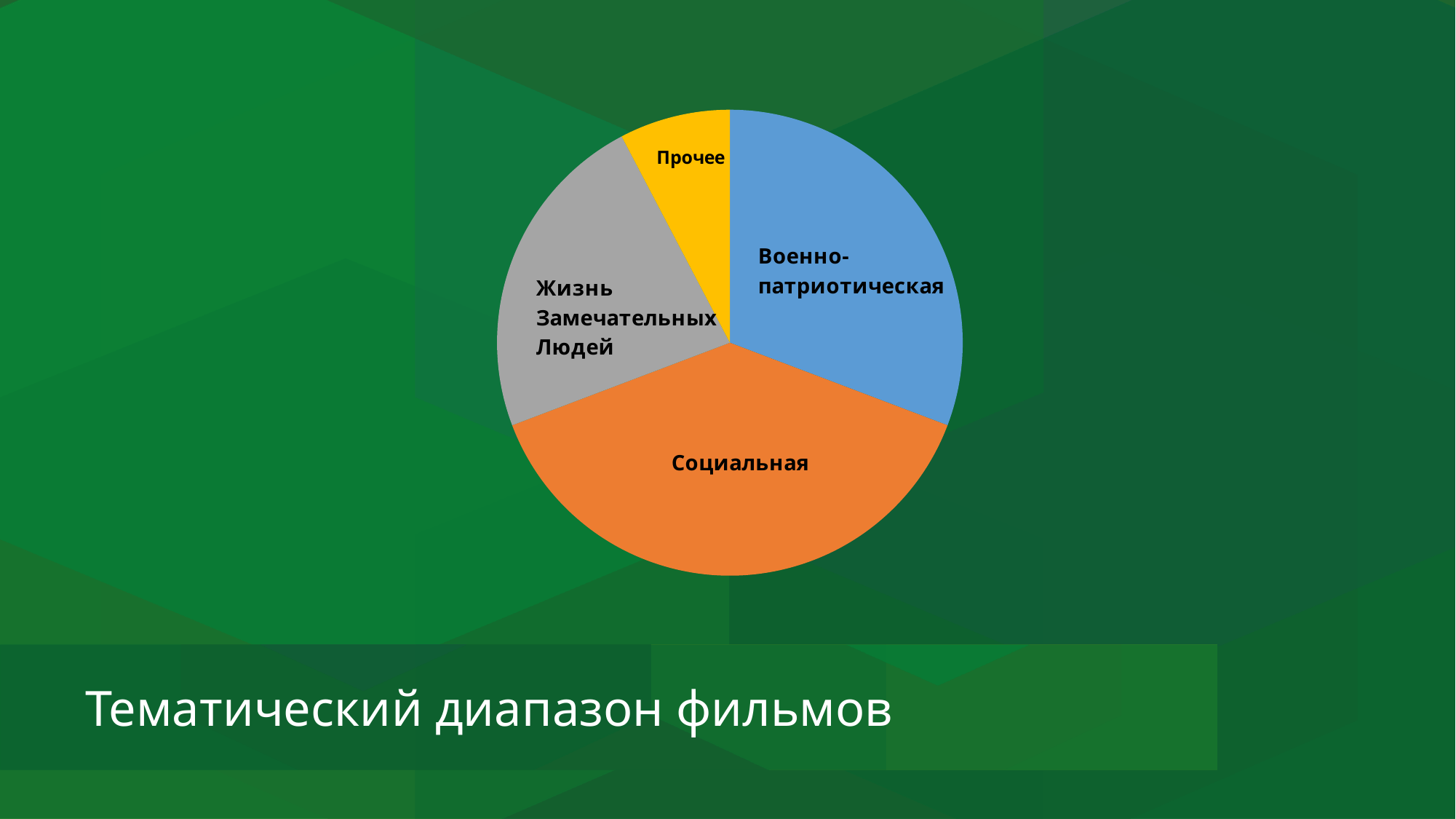
How many slices does the pie chart have? 4 Which slice is larger: Военно-патриотическая or Жизнь Замечательных Людей? Военно-патриотическая Which slice is larger: Жизнь Замечательных Людей or Прочее? Жизнь Замечательных Людей Which category has the smallest slice of the pie? Прочее What is the title of the slide containing the pie chart? Тематический диапазон фильмов What colour is the Социальная slice of the pie chart? orange Which slice is larger: Военно-патриотическая or Прочее? Военно-патриотическая What kind of chart is shown on the slide? pie chart